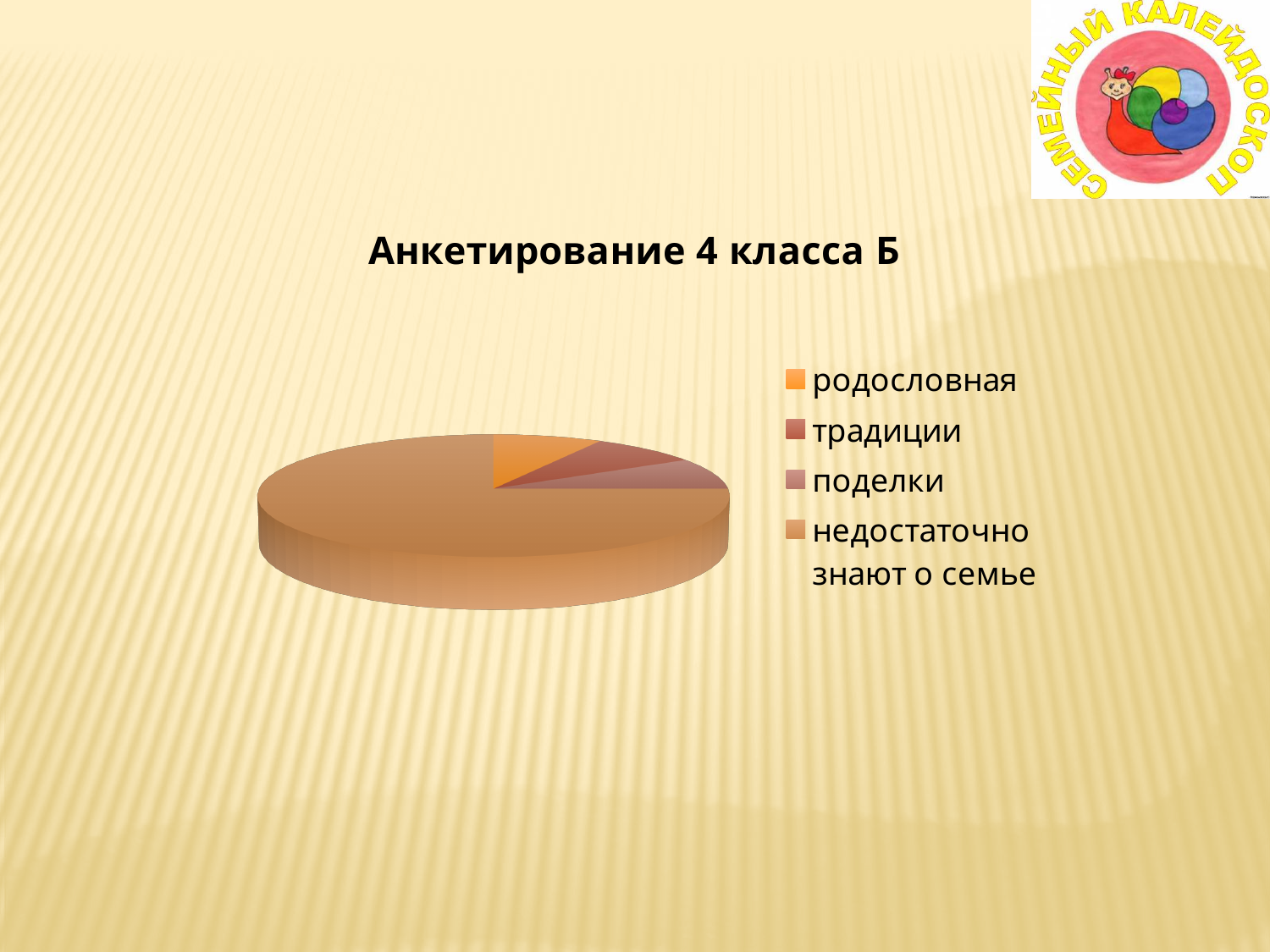
Which legend entry is shown in orange? родословная Which slice is larger: "недостаточно знают о семье" or "традиции"? недостаточно знают о семье How many slices does the pie chart have? 4 How many entries does the chart's legend list? 4 What is the title of the chart? Анкетирование 4 класса Б What kind of chart is shown on the slide? pie chart Which category has the largest slice of the pie? недостаточно знают о семье Which slice is larger: "недостаточно знают о семье" or "родословная"? недостаточно знают о семье